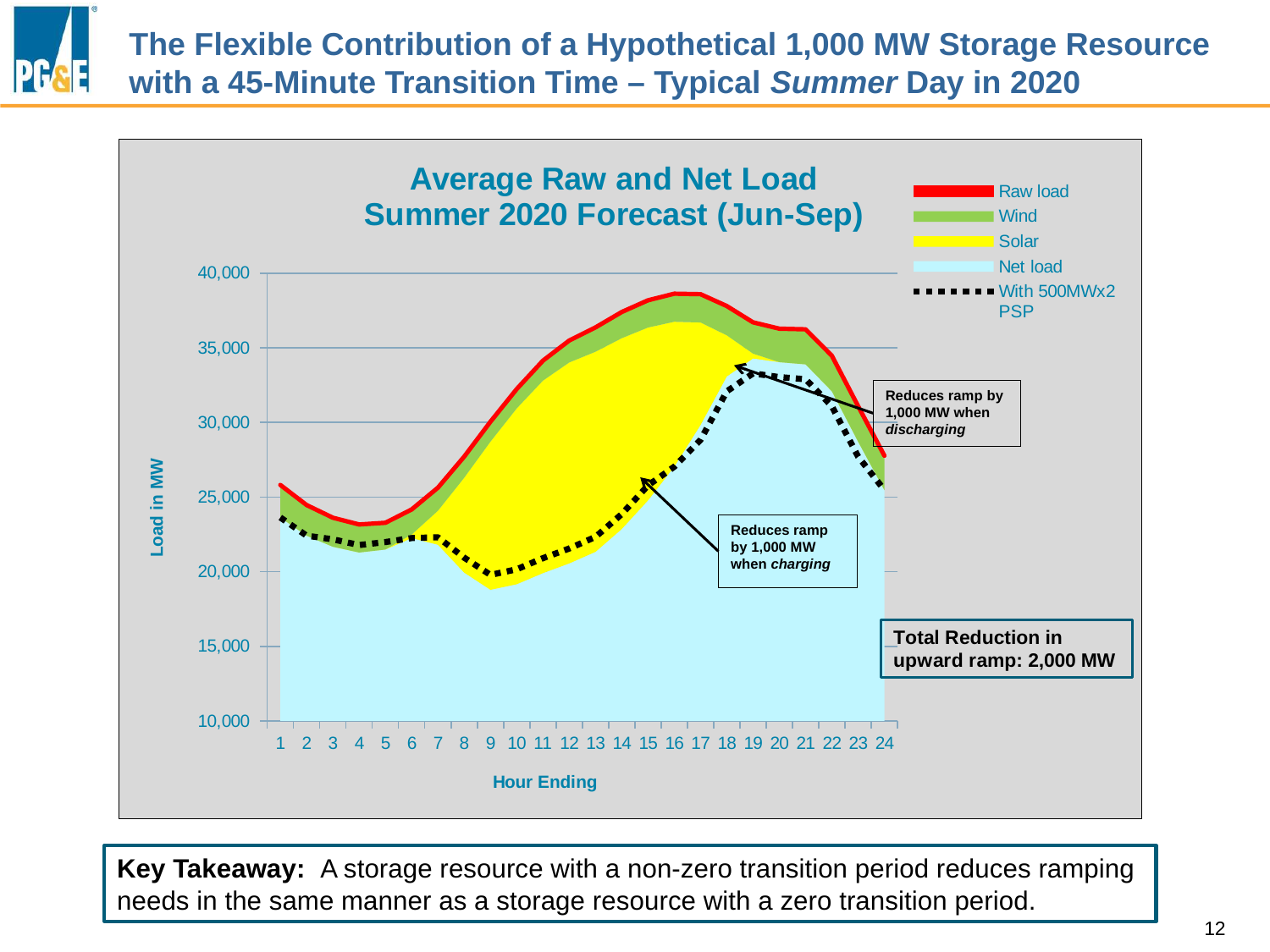
Is the net load at hour ending 9 greater or less than 20,000? less How many series does the chart legend list? 5 How many hours are plotted along the x axis? 24 Is the raw load at hour ending 4 greater or less than 25,000? less What is the title of the chart? Average Raw and Net Load Summer 2020 Forecast (Jun-Sep) Does the net load rise or fall from hour ending 19 to hour ending 24? fall Is the raw load at hour ending 12 greater or less than 30,000? greater Does the raw load rise or fall from hour ending 5 to hour ending 16? rise What is the label of the y axis? Load in MW According to the annotation on the chart, what is the total reduction in upward ramp? 2,000 MW What kind of chart is shown on the slide? area chart